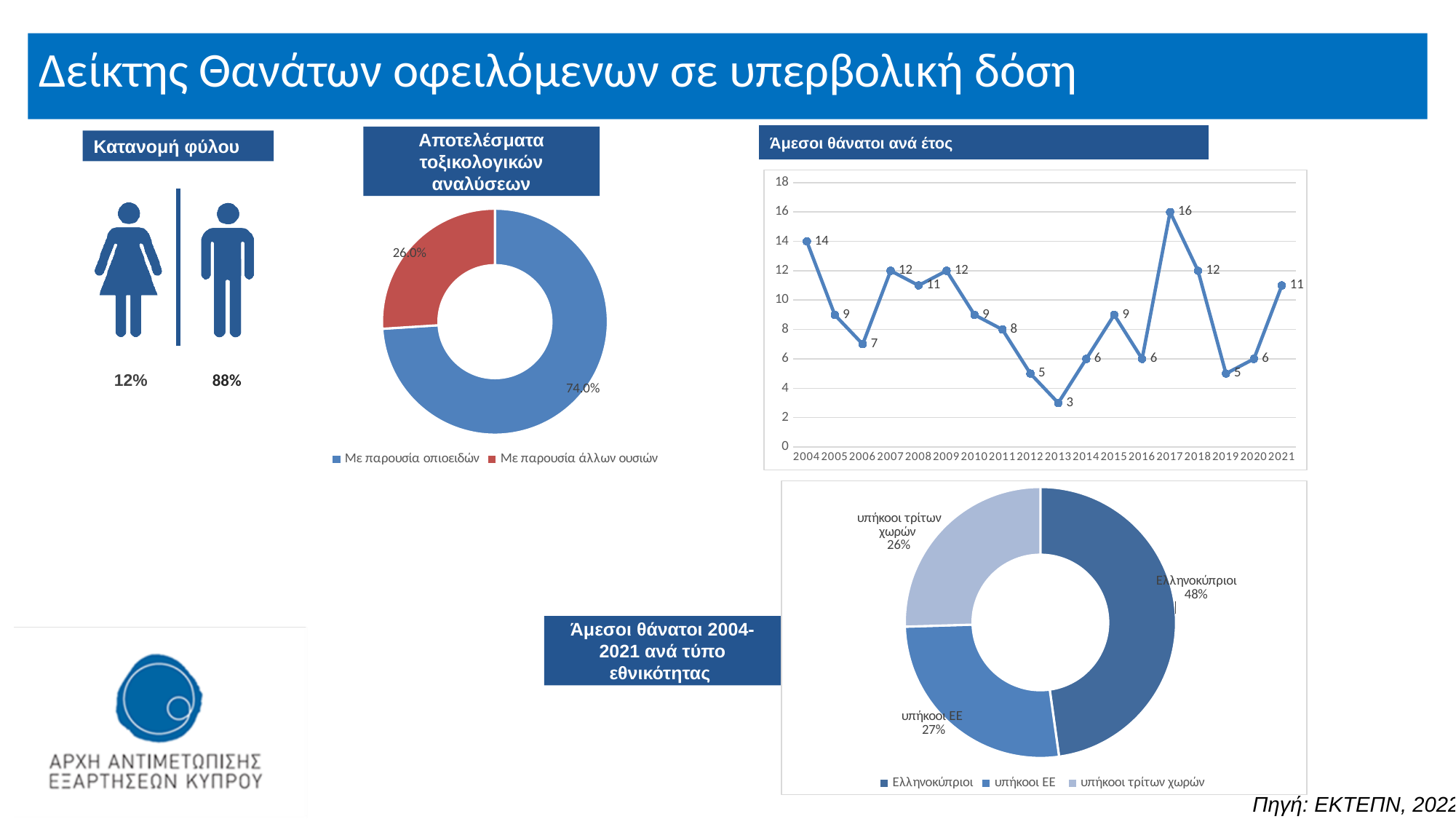
In the chart 'Άμεσοι θάνατοι 2004-2021 ανά τύπο εθνικότητας', what share is 'υπήκοοι ΕΕ'? 27% In the chart 'Άμεσοι θάνατοι 2004-2021 ανά τύπο εθνικότητας', how many categories does the legend list? 3 In the chart 'Άμεσοι θάνατοι ανά έτος', which is larger, the value for 2018 or the value for 2019? 2018 In the chart 'Άμεσοι θάνατοι 2004-2021 ανά τύπο εθνικότητας', what is the difference between the shares of 'Ελληνοκύπριοι' and 'υπήκοοι τρίτων χωρών'? 22% In the chart 'Άμεσοι θάνατοι ανά έτος', what is the value for 2017? 16 In the chart 'Άμεσοι θάνατοι ανά έτος', what is the difference between the values for 2004 and 2005? 5 What kind of chart is 'Άμεσοι θάνατοι ανά έτος'? line chart In the chart 'Άμεσοι θάνατοι ανά έτος', which year has the highest value? 2017 In the chart 'Άμεσοι θάνατοι ανά έτος', how many years are shown on the x axis? 18 In the chart 'Αποτελέσματα τοξικολογικών αναλύσεων', which category has the largest share? Με παρουσία οπιοειδών In the chart 'Αποτελέσματα τοξικολογικών αναλύσεων', what share is 'Με παρουσία άλλων ουσιών'? 26.0% In the chart 'Άμεσοι θάνατοι ανά έτος', which year has the lowest value? 2013